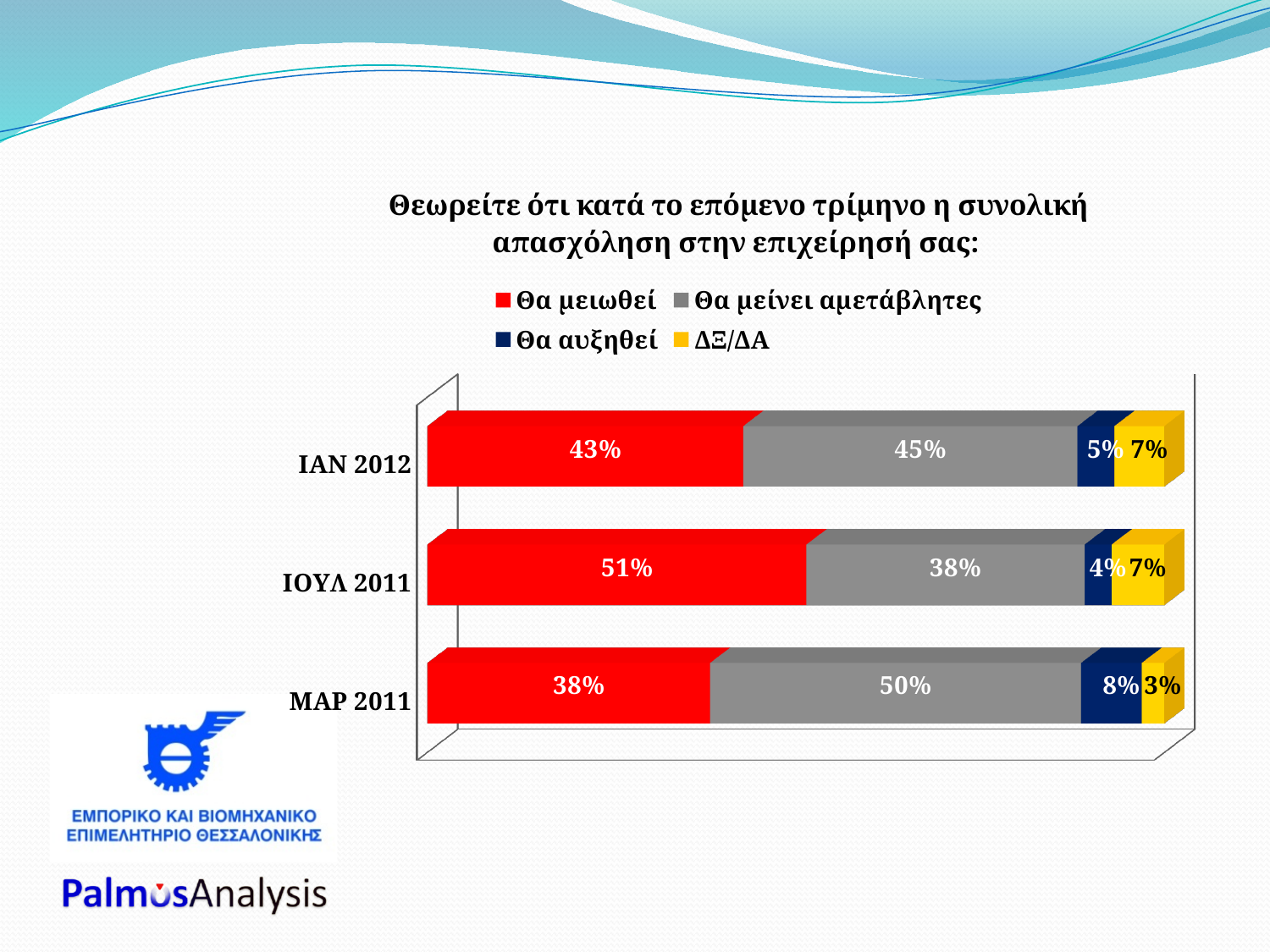
How many periods (categories) are shown on the chart? 3 Which is larger in ΙΑΝ 2012: "Θα μειωθεί" or "Θα μείνει αμετάβλητες"? Θα μείνει αμετάβλητες What is the value for "Θα μείνει αμετάβλητες" in ΜΑΡ 2011? 50% Which colour represents "ΔΞ/ΔΑ" in the chart? Yellow What is the value for "Θα μειωθεί" in ΙΑΝ 2012? 43% What kind of chart is shown on the slide? Stacked bar chart In which period is the value for "Θα μείνει αμετάβλητες" lowest? ΙΟΥΛ 2011 What is the difference between the "Θα μειωθεί" values for ΙΟΥΛ 2011 and ΜΑΡ 2011? 13% What is the value for "Θα αυξηθεί" in ΙΟΥΛ 2011? 4% What is the value for "ΔΞ/ΔΑ" in ΜΑΡ 2011? 3% How many series does the legend list? 4 In which period is the value for "Θα μειωθεί" highest? ΙΟΥΛ 2011